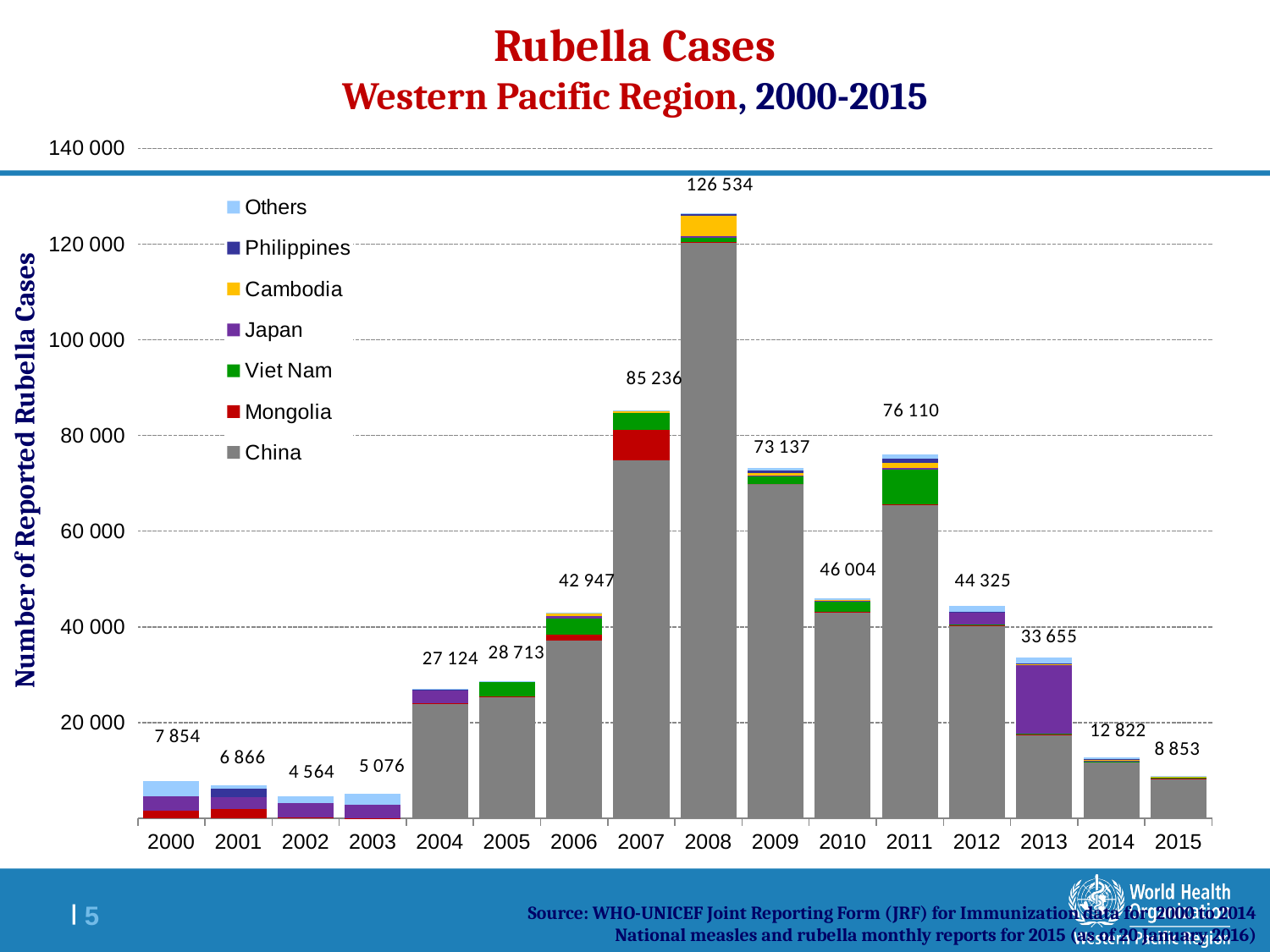
What is the total number of reported rubella cases in 2013? 33 655 What is the difference between the total cases in 2008 and 2007? 41 298 How many years are shown on the x axis? 16 Which year has more total reported rubella cases, 2009 or 2011? 2011 What kind of chart is shown on the slide? Stacked bar chart What is the total number of reported rubella cases in 2008? 126 534 Which year has the highest total number of reported rubella cases? 2008 Which year has the lowest total number of reported rubella cases? 2002 How many series does the legend list? 7 Is the value for China in 2008 greater or less than 100 000? greater Which country is represented by the grey segments in the bars? China Do the total reported rubella cases rise or fall from 2011 to 2015? Fall